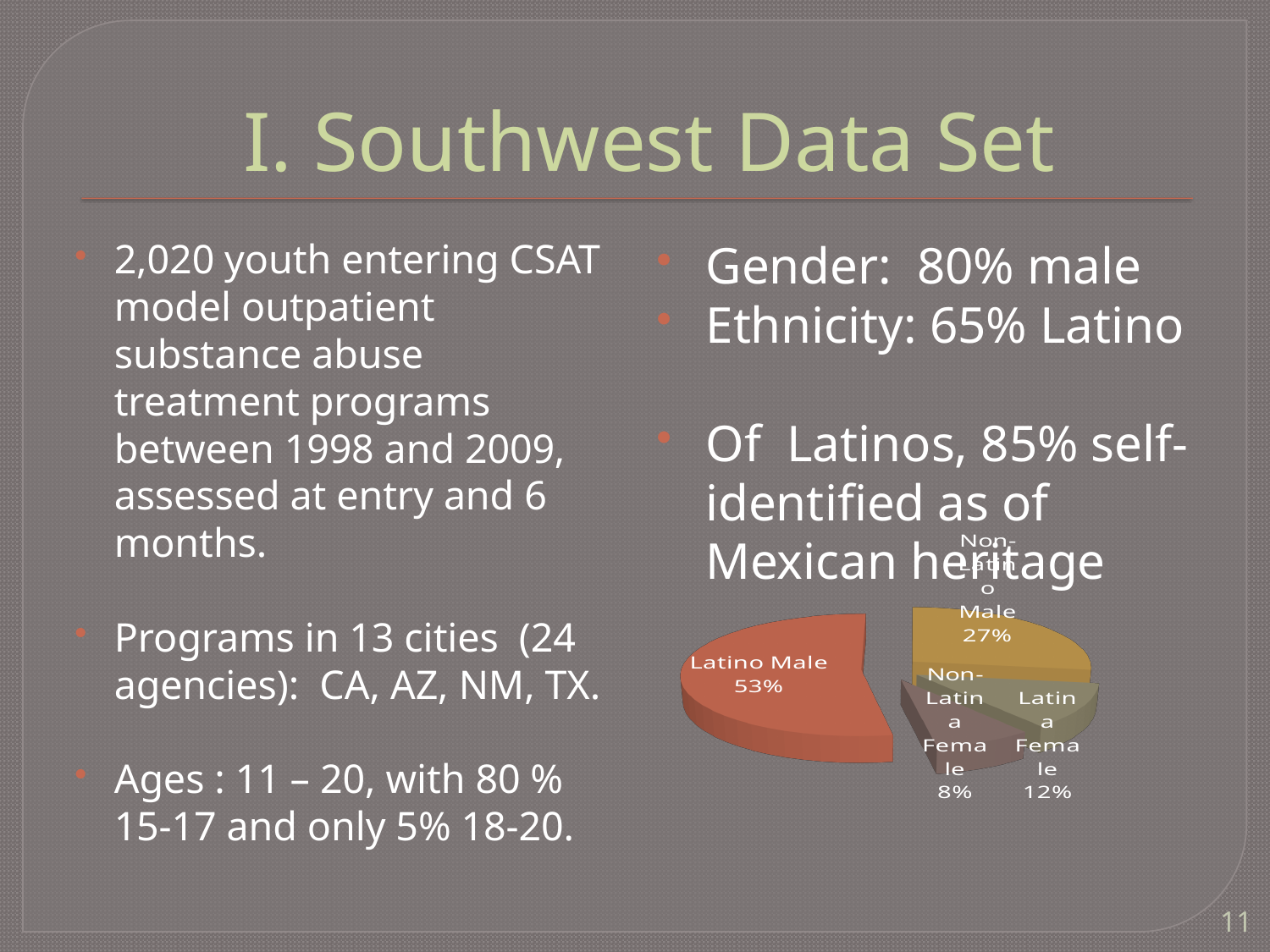
What share of the pie is Latino Male? 53% Which slice of the pie chart is the smallest? Non-Latina Female Which slice of the pie chart is the largest? Latino Male Which is larger, the Latina Female slice or the Non-Latina Female slice? Latina Female What share of the pie is Latina Female? 12% What share of the pie is Non-Latino Male? 27% What kind of chart is shown on the slide? pie chart What is the combined share of the two male slices? 80% What colour is the Latino Male slice? orange-red What is the difference in percentage points between the Latino Male and Non-Latino Male slices? 26 How many slices does the pie chart have? 4